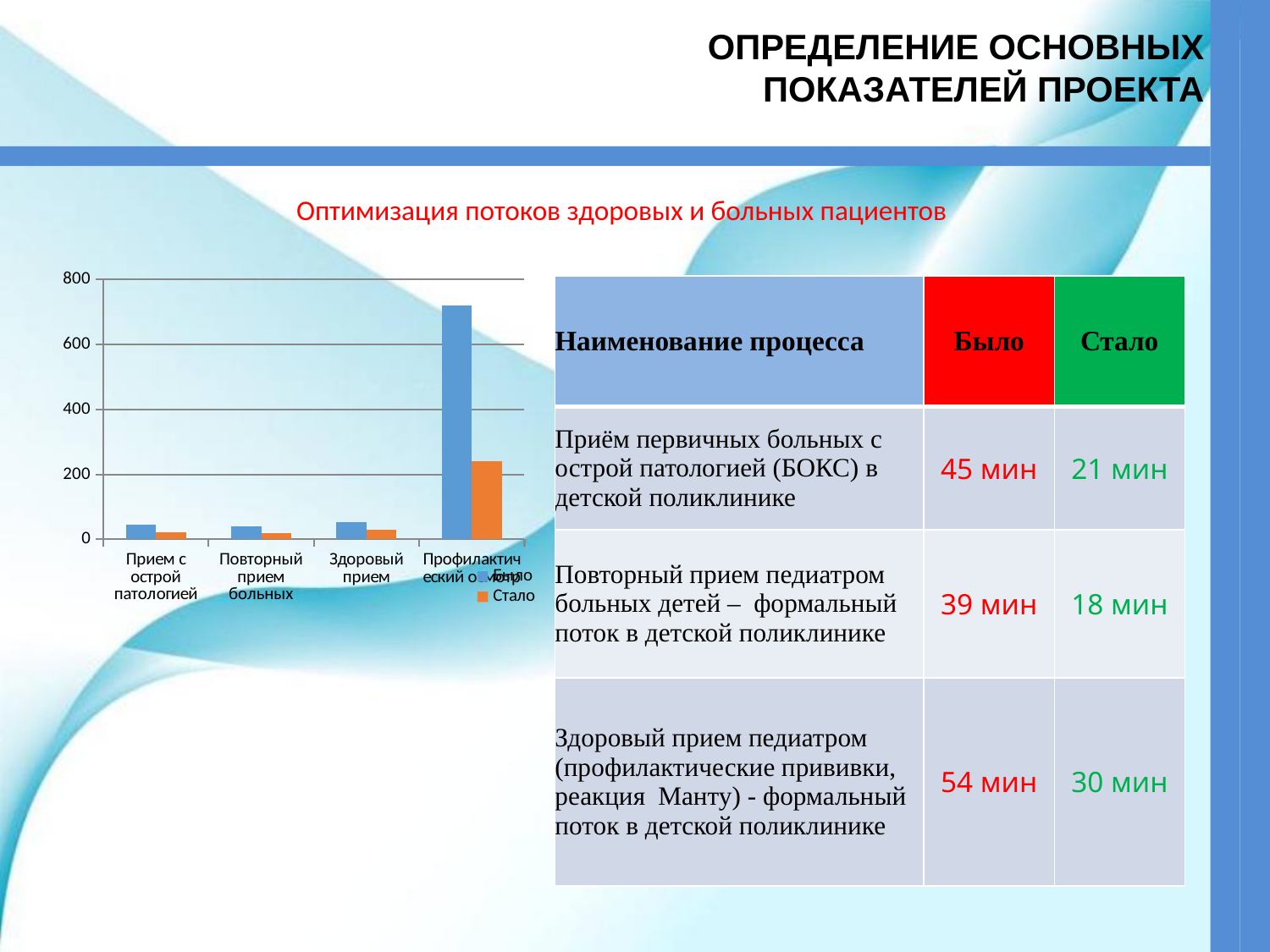
Which category has the highest Было bar in the chart? Профилактический осмотр (the rightmost category) Which category has the highest Стало bar in the chart? Профилактический осмотр (the rightmost category) What kind of chart is shown on the left of the slide? bar chart What is the highest value shown on the chart's vertical axis? 800 How many series does the chart legend list? 2 Is the Было value for Прием с острой патологией greater or less than 200? less How many categories are shown on the x axis of the chart? 4 Is the Было value for the rightmost category (Профилактический осмотр) greater or less than 600? greater For the rightmost category (Профилактический осмотр), which is larger: the Было bar or the Стало bar? Было Is the Стало value for the rightmost category (Профилактический осмотр) greater or less than 400? less For Здоровый прием, which is larger: the Было bar or the Стало bar? Было What are the two series named in the chart legend? Было and Стало